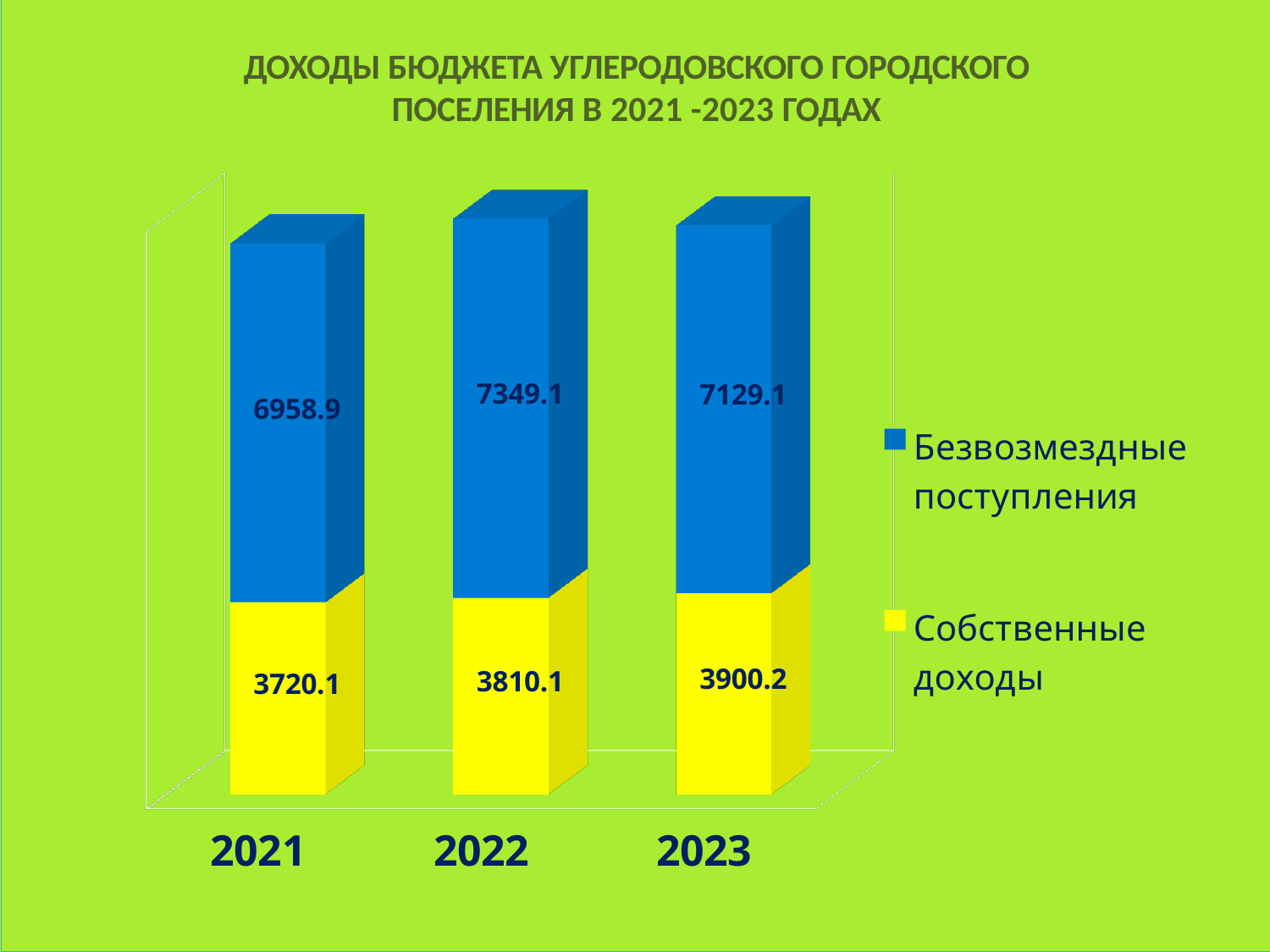
Which is larger: Безвозмездные поступления in 2021 or in 2023? 2023 In which year is Собственные доходы lowest? 2021 What is the difference between Собственные доходы in 2023 and in 2021? 180.1 What is the value of Собственные доходы for 2022? 3810.1 How many years are shown on the x axis? 3 In which year is Безвозмездные поступления highest? 2022 What is the difference between Безвозмездные поступления in 2022 and in 2023? 220.0 How many series does the legend list? 2 What is the value of Безвозмездные поступления for 2021? 6958.9 What kind of chart is shown on the slide? Stacked bar chart What is the value of Собственные доходы for 2023? 3900.2 What is the total of the stacked bar for 2022? 11159.2